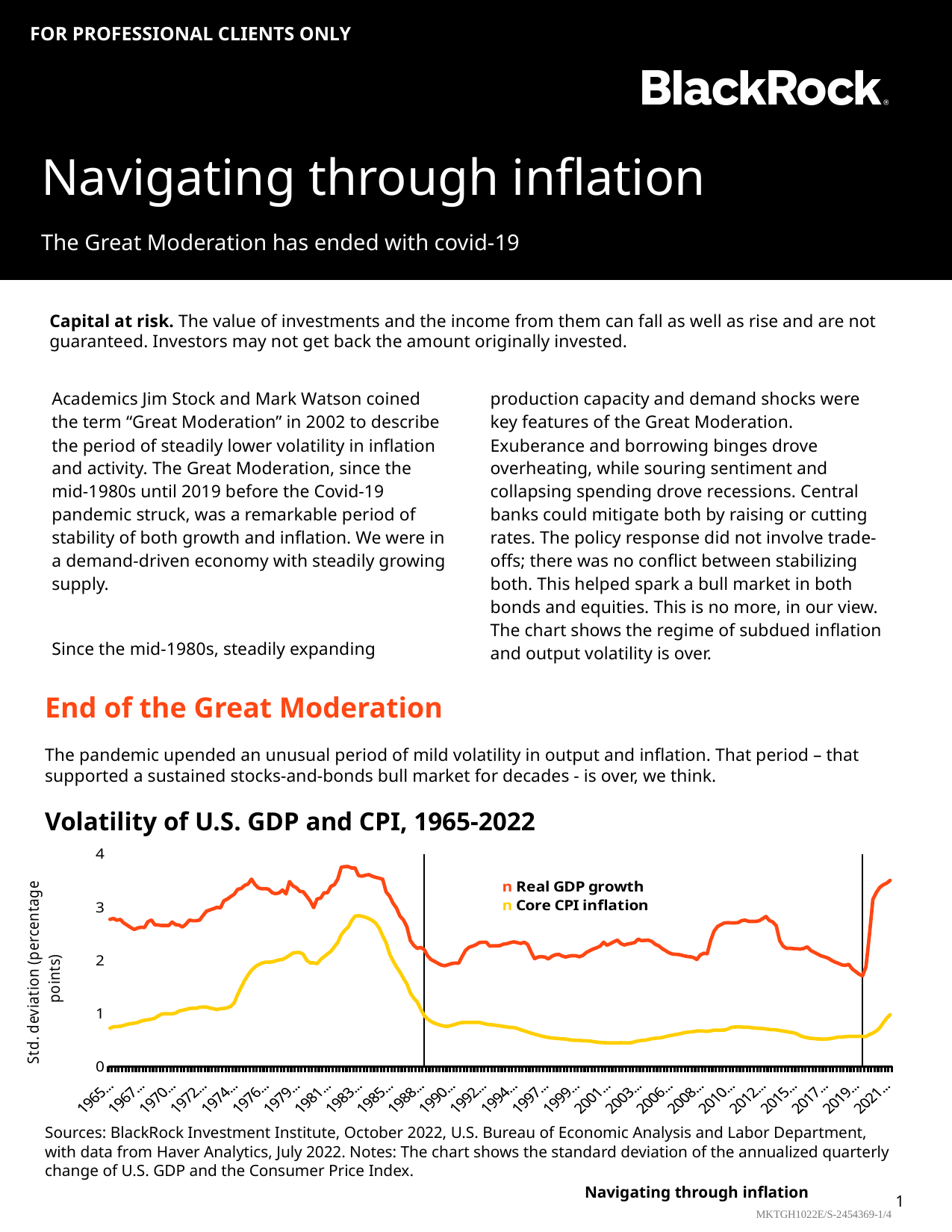
Is the value for Core CPI inflation at the start of the series (1965) greater or less than 1? less Does Core CPI inflation generally rise or fall between 1988 and 2019? Fall What is the label on the chart's vertical axis? Std. deviation (percentage points) Is the value for Real GDP growth around 1983 greater or less than 3? greater How many series does the chart's legend list? 2 What is the title of the chart? Volatility of U.S. GDP and CPI, 1965-2022 Is the value for Real GDP growth at the end of the series (2021) greater or less than 3? greater Which series has the higher value in 1965, Real GDP growth or Core CPI inflation? Real GDP growth What kind of chart is shown on the slide? Line chart Does Real GDP growth rise or fall between 1983 and 1988? Fall